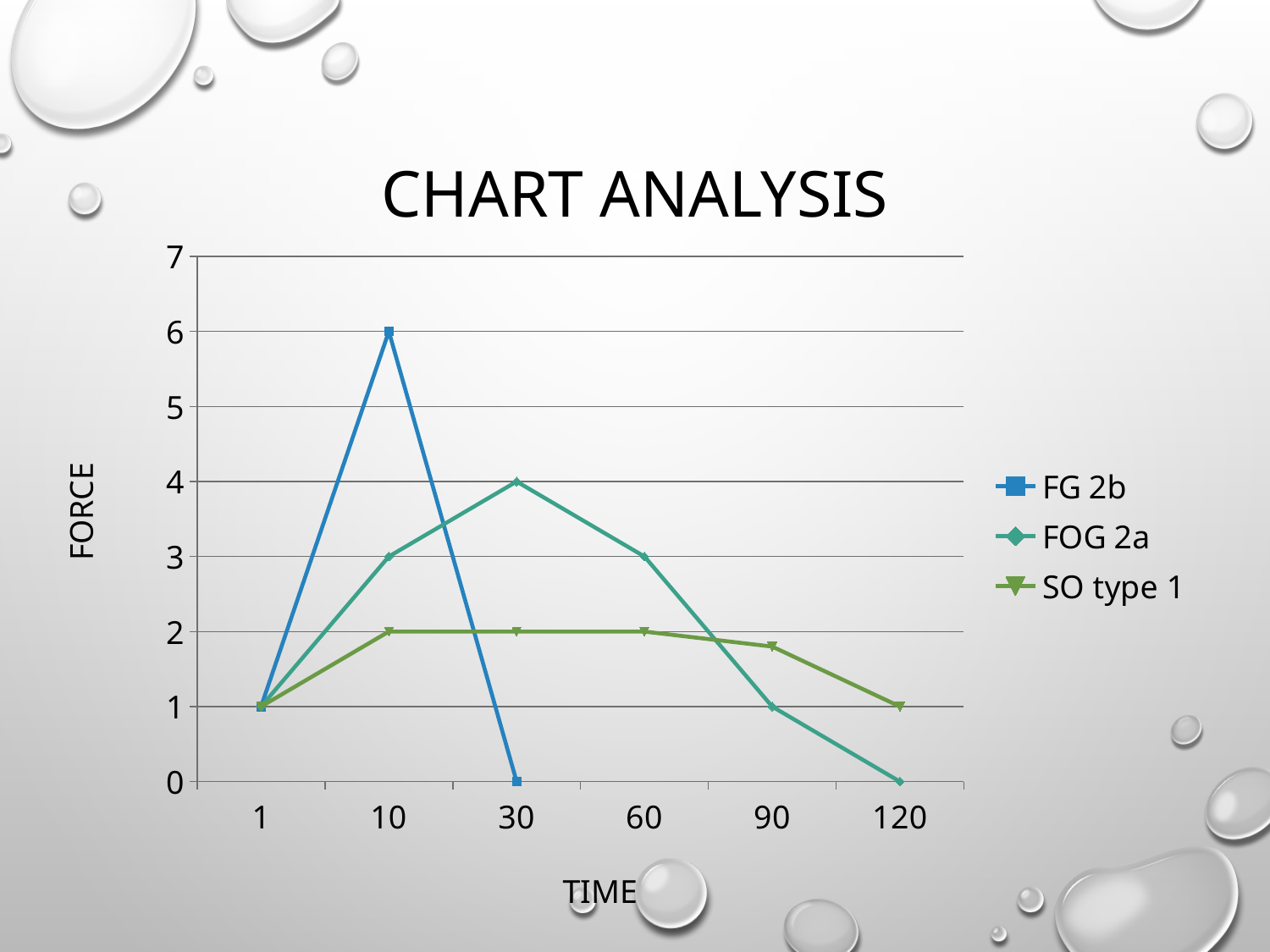
What is the force value for FG 2b at time 10? 6 What kind of chart is shown on the slide? line chart What is the force value for FOG 2a at time 30? 4 What is the difference between the force of FG 2b and SO type 1 at time 10? 4 Which series has the higher force at time 10, FG 2b or FOG 2a? FG 2b Is the force value for SO type 1 at time 90 greater or less than 2? less At which time does FG 2b reach its lowest force? 30 What is the force value for SO type 1 at time 60? 2 Does the force for FOG 2a rise or fall between time 60 and time 120? fall How many time points are labelled on the x axis? 6 At which time does FOG 2a reach its highest force? 30 How many series does the legend list? 3